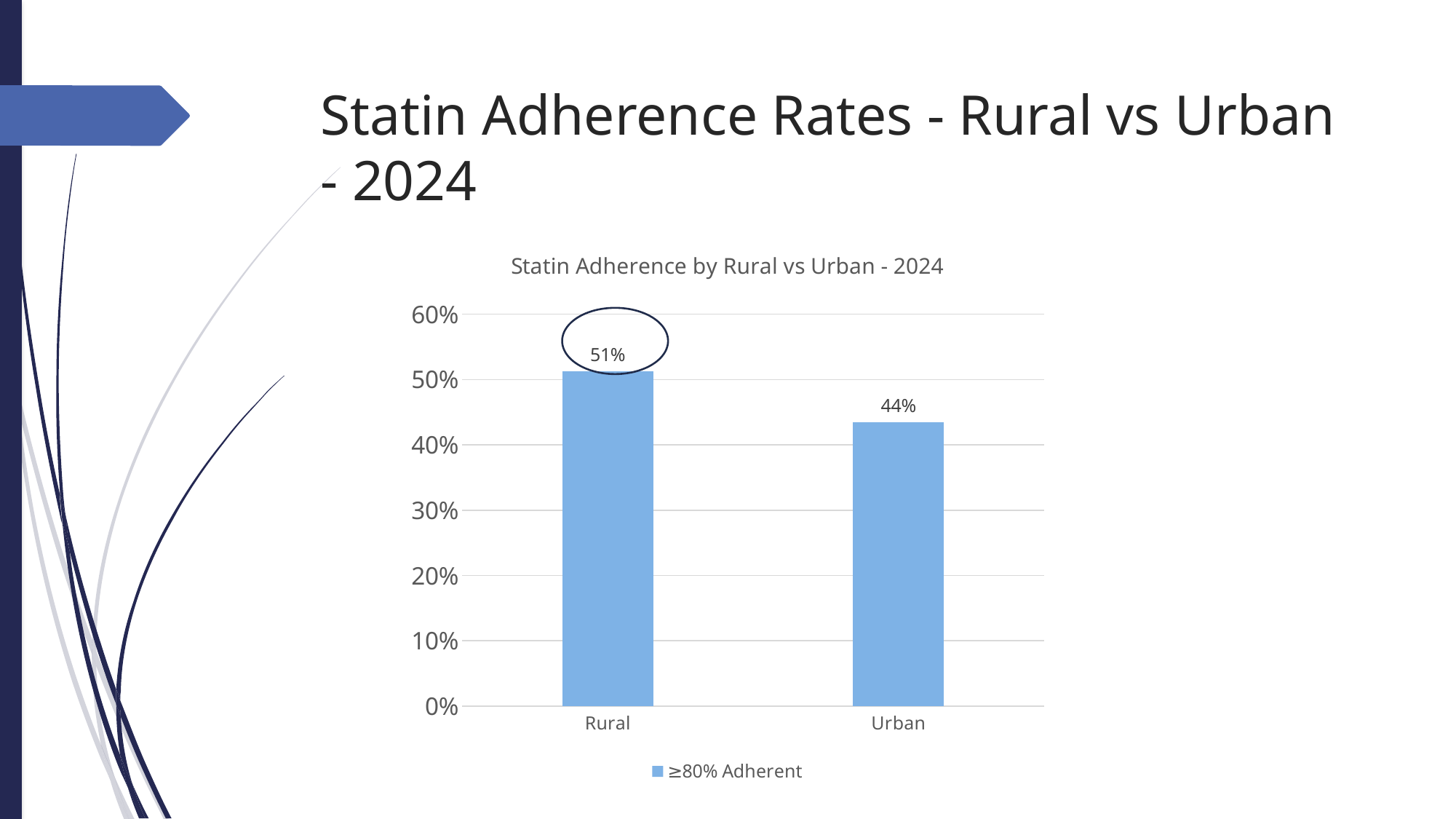
What is the value for Urban? 44% What is the difference between the Rural and Urban values? 7% Which is larger, the value for Rural or the value for Urban? Rural What is the title of the chart? Statin Adherence by Rural vs Urban - 2024 Which category has the highest value? Rural How many series does the legend list? 1 What kind of chart is shown? bar chart How many categories are shown on the x axis? 2 Is the value for Urban greater or less than 50%? less What is the value for Rural? 51% Which category has the lowest value? Urban Is the value for Rural greater or less than 50%? greater